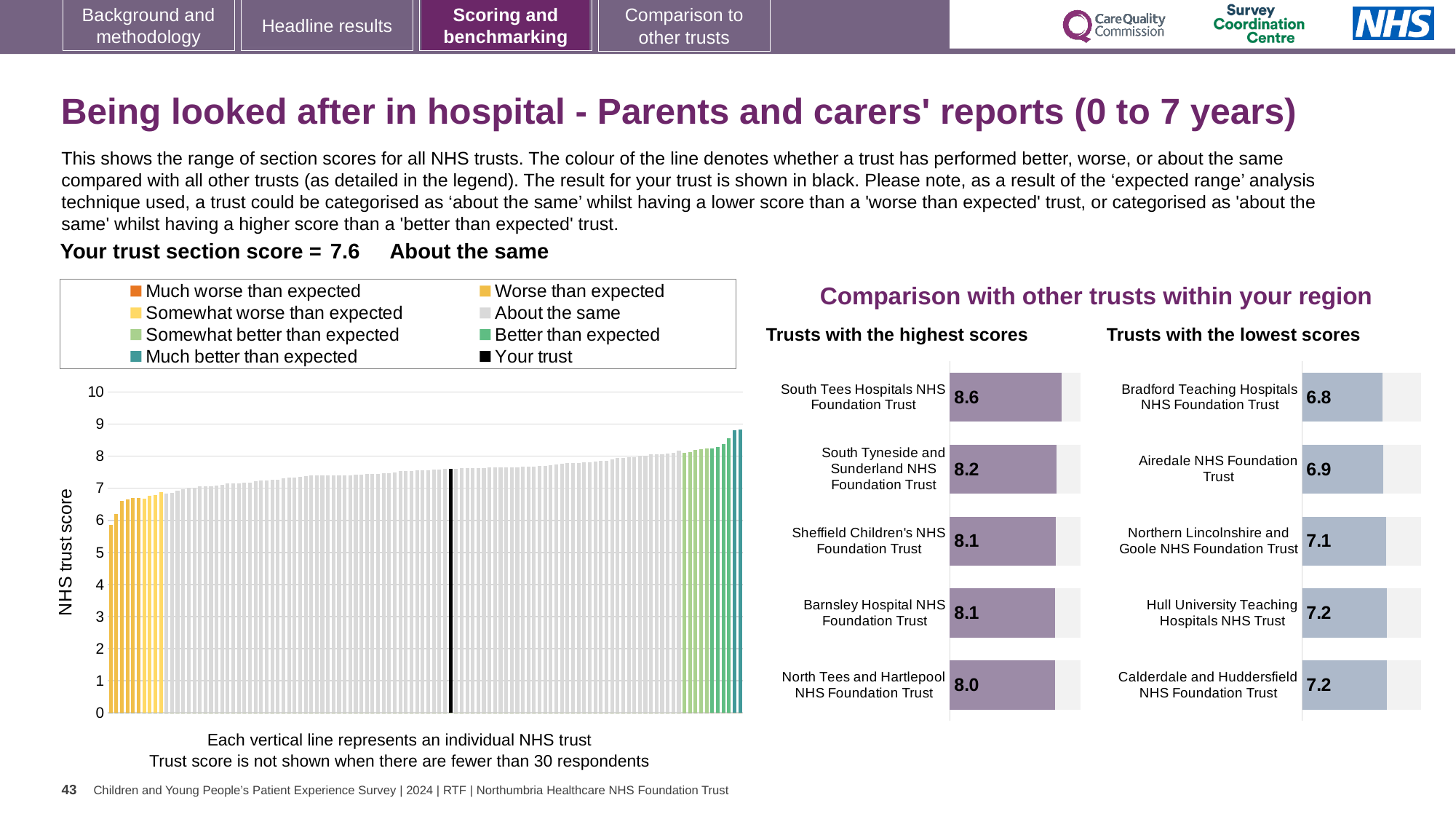
What kind of chart is the 'NHS trust score' chart on the left of the slide? Bar chart In the 'Trusts with the highest scores' chart, what is the score for South Tees Hospitals NHS Foundation Trust? 8.6 Which is larger: the score for Airedale NHS Foundation Trust in the 'Trusts with the lowest scores' chart or the score for Sheffield Children's NHS Foundation Trust in the 'Trusts with the highest scores' chart? Sheffield Children's NHS Foundation Trust In the 'Trusts with the lowest scores' chart, what is the score for Bradford Teaching Hospitals NHS Foundation Trust? 6.8 In the 'Trusts with the highest scores' chart, what is the difference between the scores of South Tees Hospitals NHS Foundation Trust and North Tees and Hartlepool NHS Foundation Trust? 0.6 In the 'Trusts with the highest scores' chart, which trust has the highest score? South Tees Hospitals NHS Foundation Trust In the 'NHS trust score' chart, is the value for the black 'Your trust' bar greater or less than 7? greater How many trusts are shown in the 'Trusts with the lowest scores' chart? 5 In the 'Trusts with the lowest scores' chart, what is the difference between the scores of Calderdale and Huddersfield NHS Foundation Trust and Bradford Teaching Hospitals NHS Foundation Trust? 0.4 In the 'Trusts with the lowest scores' chart, which trust has the lowest score? Bradford Teaching Hospitals NHS Foundation Trust In the 'Trusts with the highest scores' chart, what is the score for North Tees and Hartlepool NHS Foundation Trust? 8.0 How many entries does the legend of the 'NHS trust score' chart list? 8